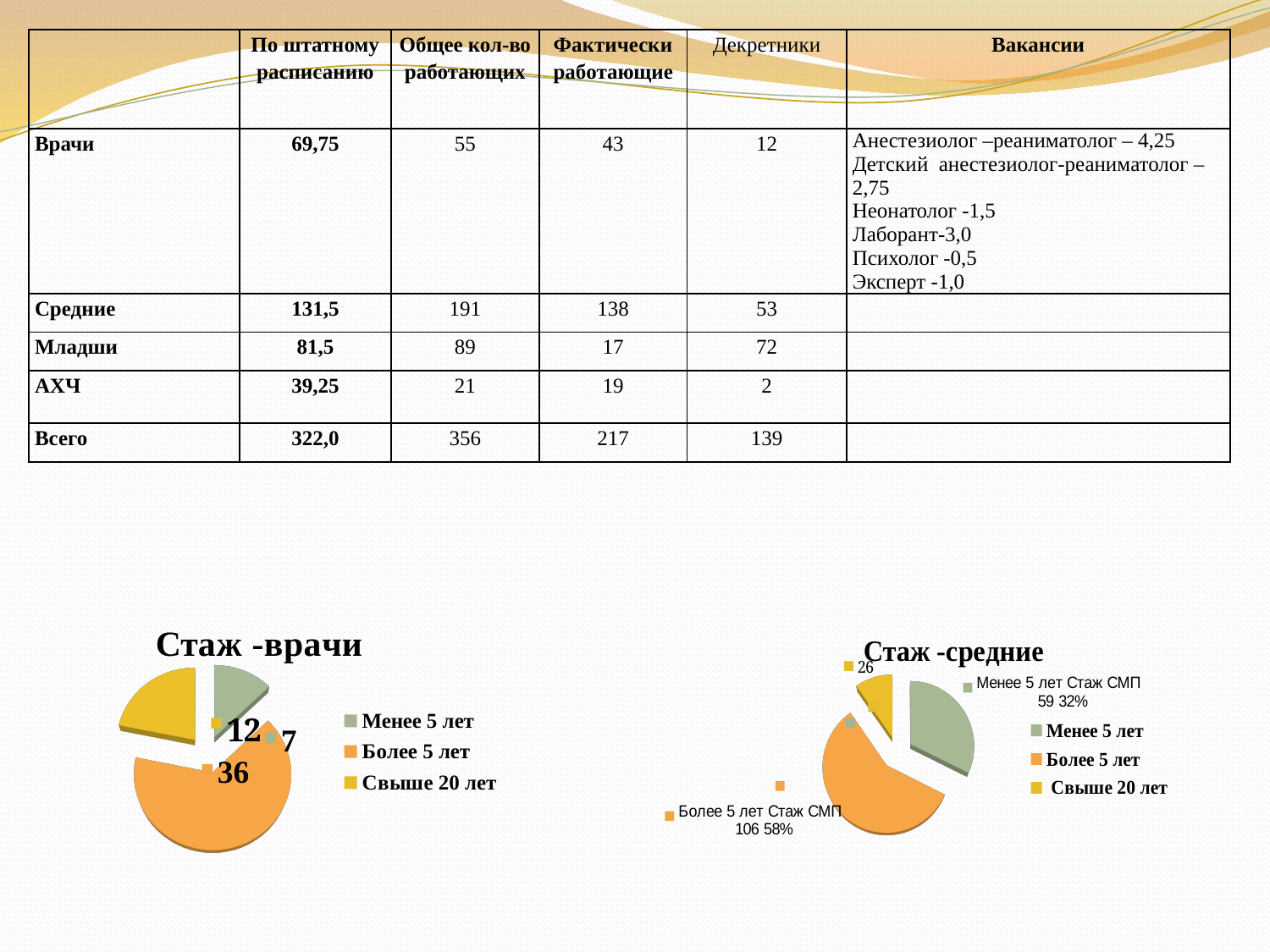
What kind of chart is the "Стаж -врачи" chart? pie chart In the "Стаж -врачи" chart, what is the difference between "Более 5 лет" and "Менее 5 лет"? 29 In the "Стаж -врачи" chart, what is the value for "Свыше 20 лет"? 12 In the "Стаж -средние" chart, what percentage share does "Менее 5 лет" have? 32% In the "Стаж -средние" chart, which category has the largest slice? Более 5 лет In the "Стаж -врачи" chart, which category has the largest slice? Более 5 лет In the "Стаж -врачи" chart, what is the value for "Более 5 лет"? 36 In the "Стаж -средние" chart, which is larger: "Менее 5 лет" or "Свыше 20 лет"? Менее 5 лет How many slices does the "Стаж -врачи" pie chart have? 3 In the "Стаж -средние" chart, what is the value for "Более 5 лет"? 106 In the "Стаж -врачи" chart, which category has the smallest slice? Менее 5 лет